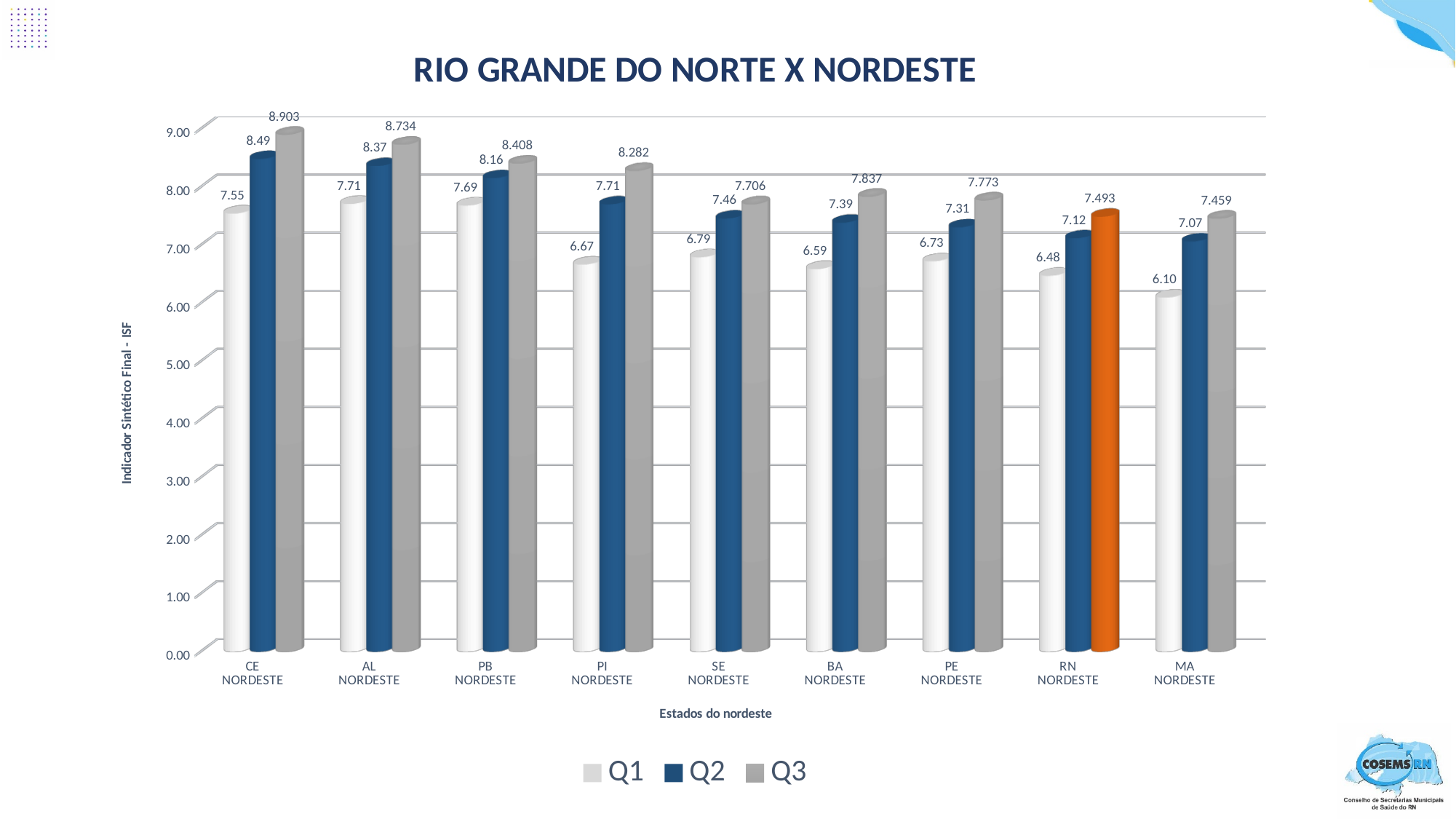
How many series does the legend list? 3 How many states are shown on the x axis? 9 What is the Q1 value for RN NORDESTE? 6.48 Which is larger, the Q2 value for PB NORDESTE or the Q2 value for PI NORDESTE? PB NORDESTE What is the title of the chart? RIO GRANDE DO NORTE X NORDESTE What is the Q2 value for MA NORDESTE? 7.07 Which state's Q3 bar is coloured orange instead of grey? RN NORDESTE What kind of chart is shown on the slide? Bar chart Which state has the highest Q3 value? CE NORDESTE What is the difference between the Q3 and Q1 values for RN NORDESTE? 1.013 Which state has the lowest Q1 value? MA NORDESTE What is the Q3 value for CE NORDESTE? 8.903